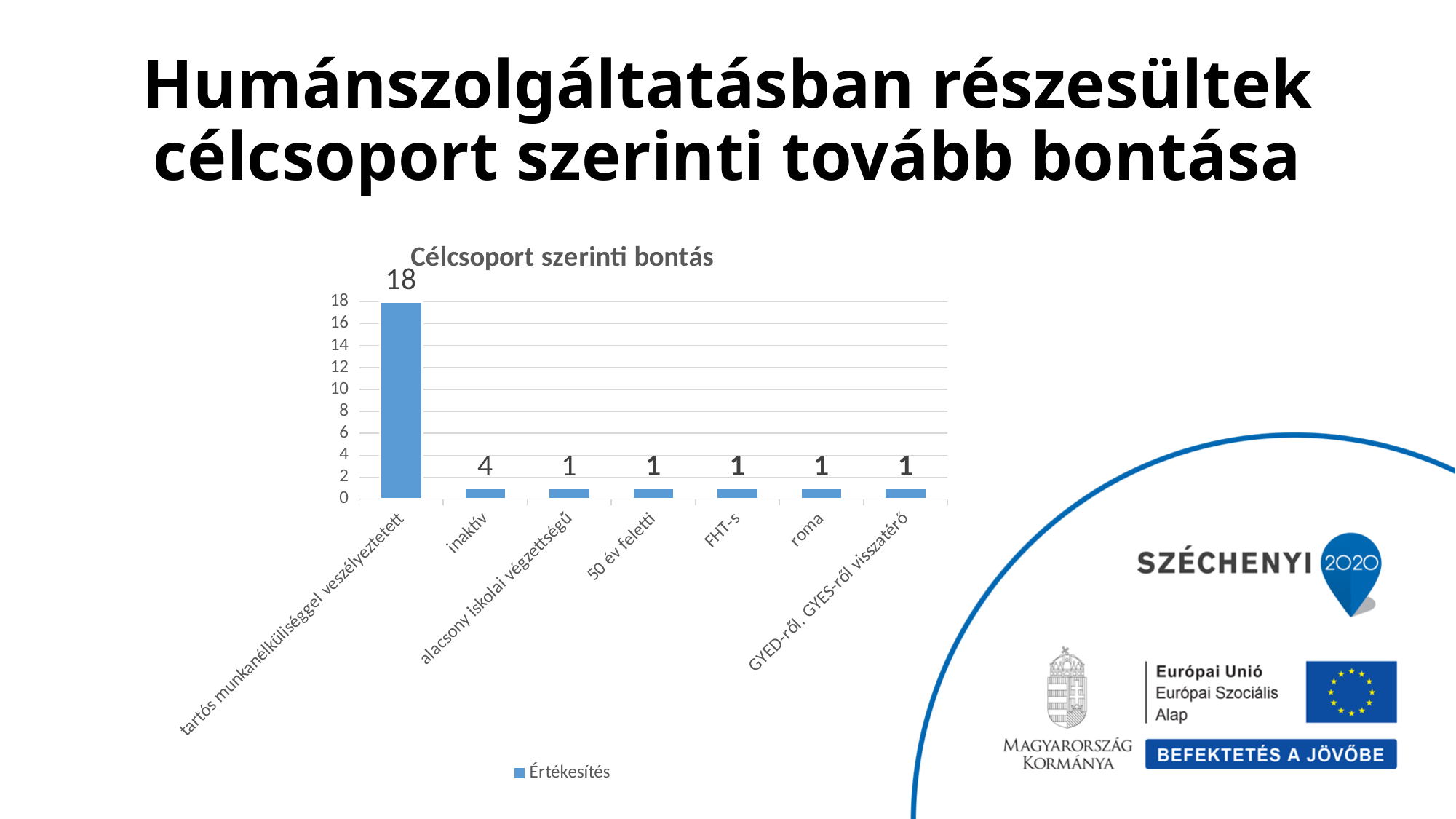
What is the title of the chart? Célcsoport szerinti bontás What is the value for roma in the chart? 1 What is the value for tartós munkanélküliséggel veszélyeztetett? 18 How many categories are shown on the x axis of the chart? 7 What kind of chart is shown on the slide? bar chart What is the value for 50 év feletti? 1 How many series does the chart legend list? 1 Which category has the highest value in the chart? tartós munkanélküliséggel veszélyeztetett